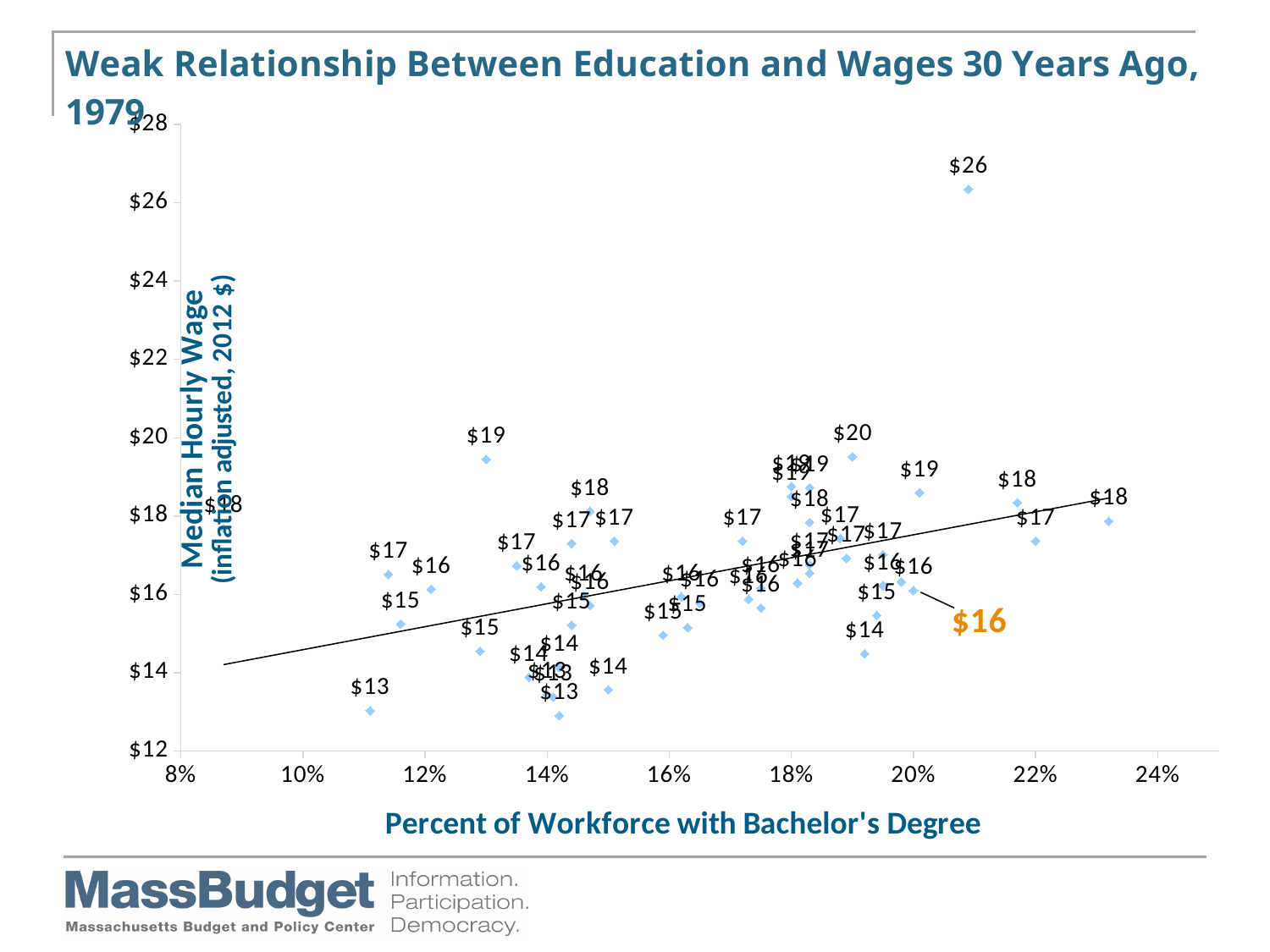
What is the highest median hourly wage labeled on the chart? $26 What kind of chart is shown on the slide? scatter chart What is the highest value shown on the y axis? $28 Is the median hourly wage of the point near 11% labeled $13 greater or less than $14? less Which is larger: the wage of the point labeled $26 or the wage of the point labeled $20? $26 What is the difference between the highest labeled wage ($26) and the lowest labeled wage ($13)? $13 What value is shown by the orange highlighted data label on the chart? $16 Is the median hourly wage of the highest point on the chart (near 21%) greater or less than $24? greater Does the fitted trend line rise or fall as the percent of workforce with a bachelor's degree increases? rises What is the lowest median hourly wage labeled on the chart? $13 What is the title of the chart? Weak Relationship Between Education and Wages 30 Years Ago, 1979 What is the title of the x axis? Percent of Workforce with Bachelor's Degree